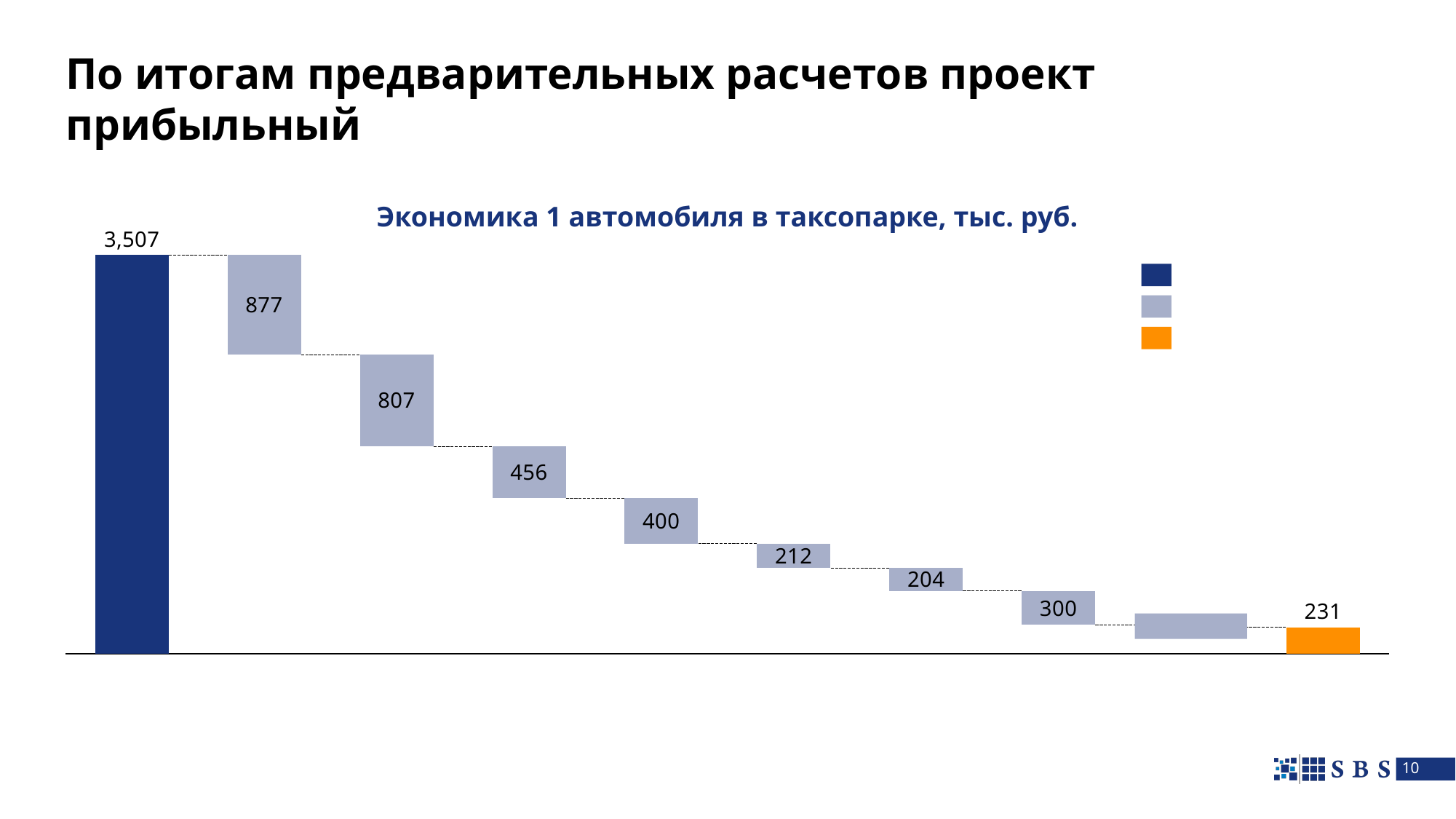
How many colour swatches does the legend show? 3 Which labeled value on the chart is the highest? 3,507 Which labeled value on the chart is the lowest? 204 What kind of chart is shown on the slide? bar chart What is the difference between the second bar (877) and the third bar (807)? 70 What is the title of the chart? Экономика 1 автомобиля в таксопарке, тыс. руб. What is the value of the first (dark blue) bar on the left? 3,507 What is the value of the last (orange) bar on the right? 231 Which is larger, the bar labeled 212 or the bar labeled 204? 212 What is the value of the second bar from the left? 877 How many bars are plotted on the chart? 10 What is the value of the fourth bar from the left? 456